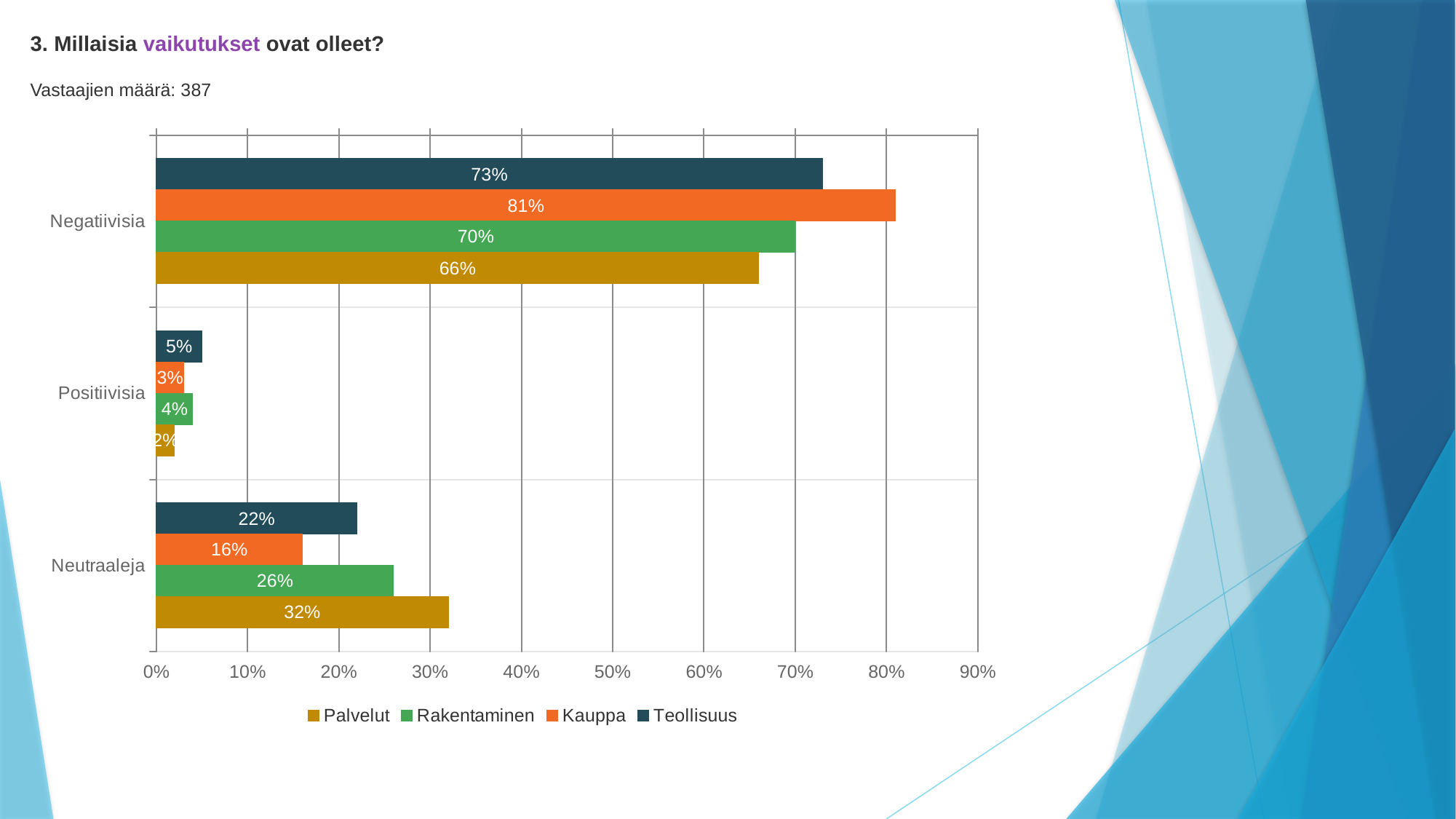
How many categories are shown on the vertical axis? 3 What is the difference between the Kauppa and Palvelut values in the Negatiivisia category? 15% What is the value for Kauppa in the Negatiivisia category? 81% Which series has the lowest value in the Neutraaleja category? Kauppa What is the value for Teollisuus in the Positiivisia category? 5% In the Neutraaleja category, which is larger: Rakentaminen or Teollisuus? Rakentaminen How many series does the legend list? 4 What is the value for Palvelut in the Neutraaleja category? 32% Is the value for Teollisuus in the Negatiivisia category greater or less than 70%? greater Which series has the highest value in the Negatiivisia category? Kauppa Which series is shown in orange in the legend? Kauppa What kind of chart is shown on the slide? bar chart